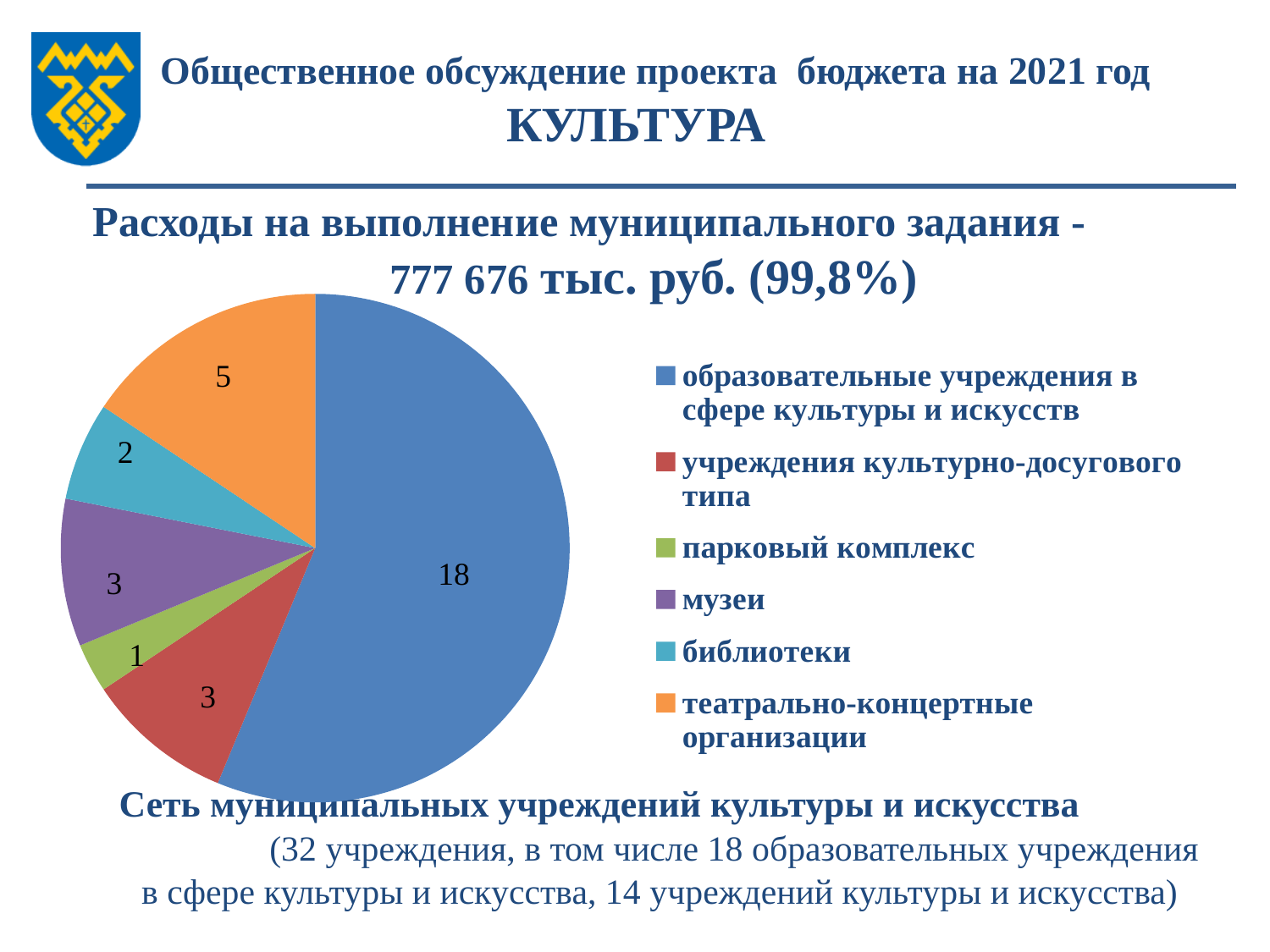
What value does the pie chart show for музеи? 3 What colour is the slice for музеи in the pie chart? purple Which category has the smallest slice in the pie chart? парковый комплекс What value does the pie chart show for парковый комплекс? 1 What value does the pie chart show for библиотеки? 2 What value does the pie chart show for театрально-концертные организации? 5 What kind of chart is shown on the slide? pie chart Which is larger: the value for библиотеки or the value for театрально-концертные организации? театрально-концертные организации What is the difference between the values for образовательные учреждения в сфере культуры и искусств and театрально-концертные организации? 13 How many categories does the pie chart legend list? 6 Which category has the largest slice in the pie chart? образовательные учреждения в сфере культуры и искусств How many institutions does the pie chart show for образовательные учреждения в сфере культуры и искусств? 18